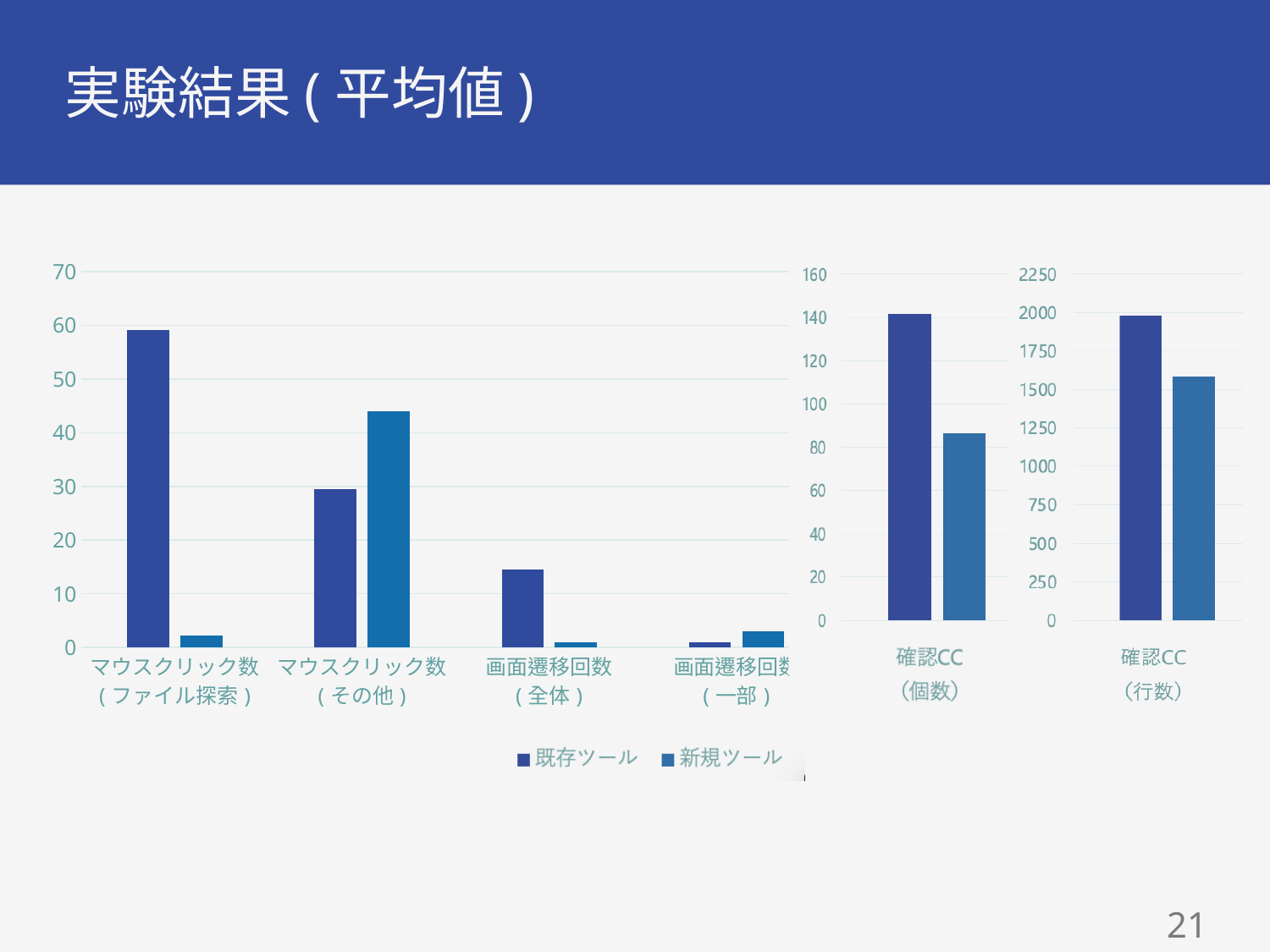
In the middle chart (確認CC（個数）), is the value of the 新規ツール bar greater or less than 100? less In the left chart, for マウスクリック数（ファイル探索）, which series has the larger value, 既存ツール or 新規ツール? 既存ツール How many categories are shown on the x axis of the left chart? 4 In the left chart, is the value of 新規ツール for マウスクリック数（その他） greater or less than 40? greater In the left chart, is the value of 既存ツール for 画面遷移回数（全体） greater or less than 10? greater In the left chart, which category has the highest 既存ツール value? マウスクリック数（ファイル探索） In the left chart, for マウスクリック数（その他）, which series has the larger value, 既存ツール or 新規ツール? 新規ツール How many series does the legend of the left chart list? 2 What kind of chart is the left chart on the slide? bar chart